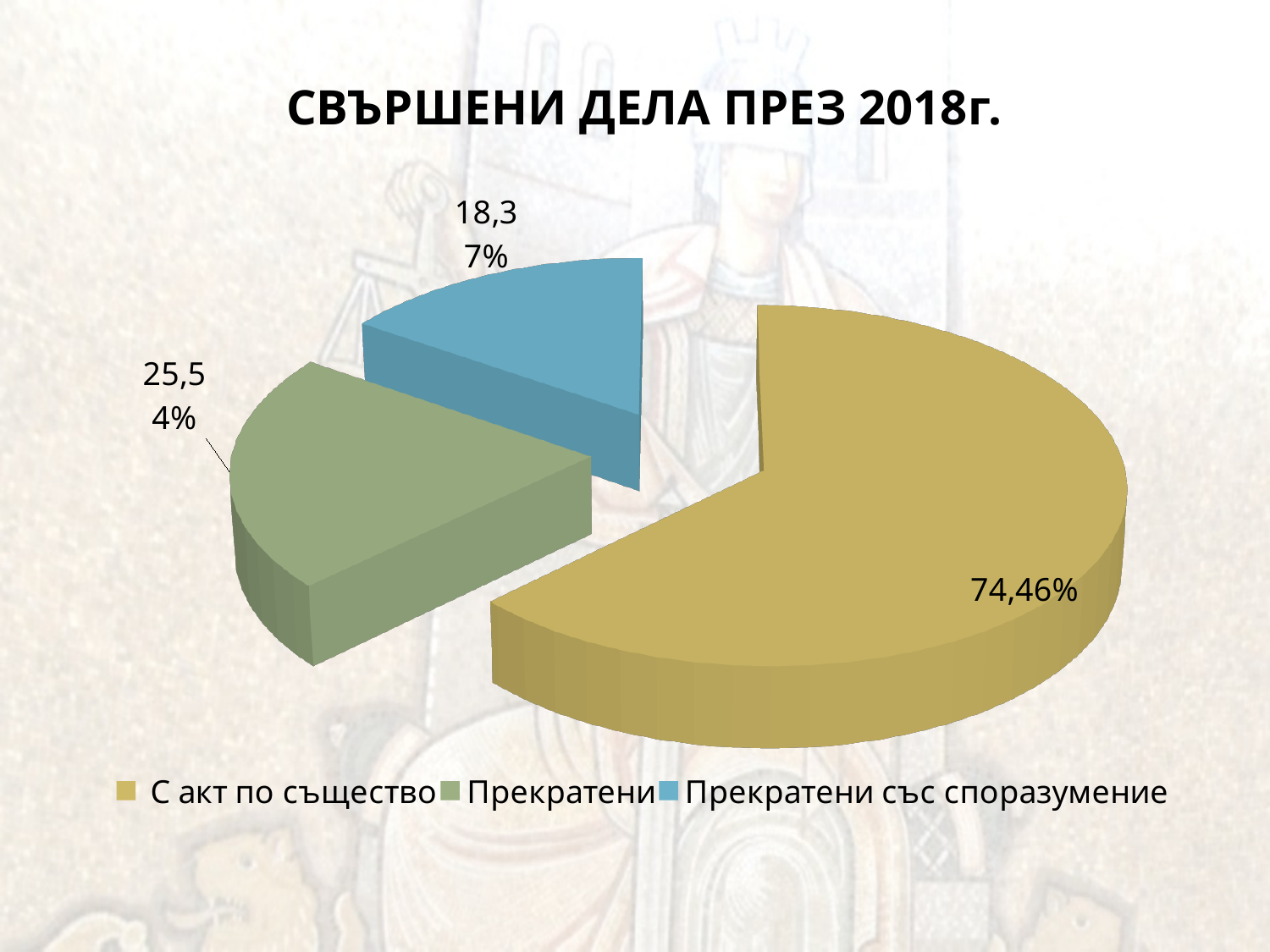
What is the chart title? СВЪРШЕНИ ДЕЛА ПРЕЗ 2018г. How many slices does the pie chart have? 3 What percentage is shown for Прекратени със споразумение? 18,37% What colour is the slice for Прекратени със споразумение? blue Which is larger, Прекратени or Прекратени със споразумение? Прекратени What percentage is shown for Прекратени? 25,54% What is the difference between the percentages for С акт по същество and Прекратени? 48,92% How many entries does the legend list? 3 What type of chart is shown on the slide? pie chart What percentage is shown for С акт по същество? 74,46% Which category has the largest slice of the pie? С акт по същество Which category has the smallest slice of the pie? Прекратени със споразумение